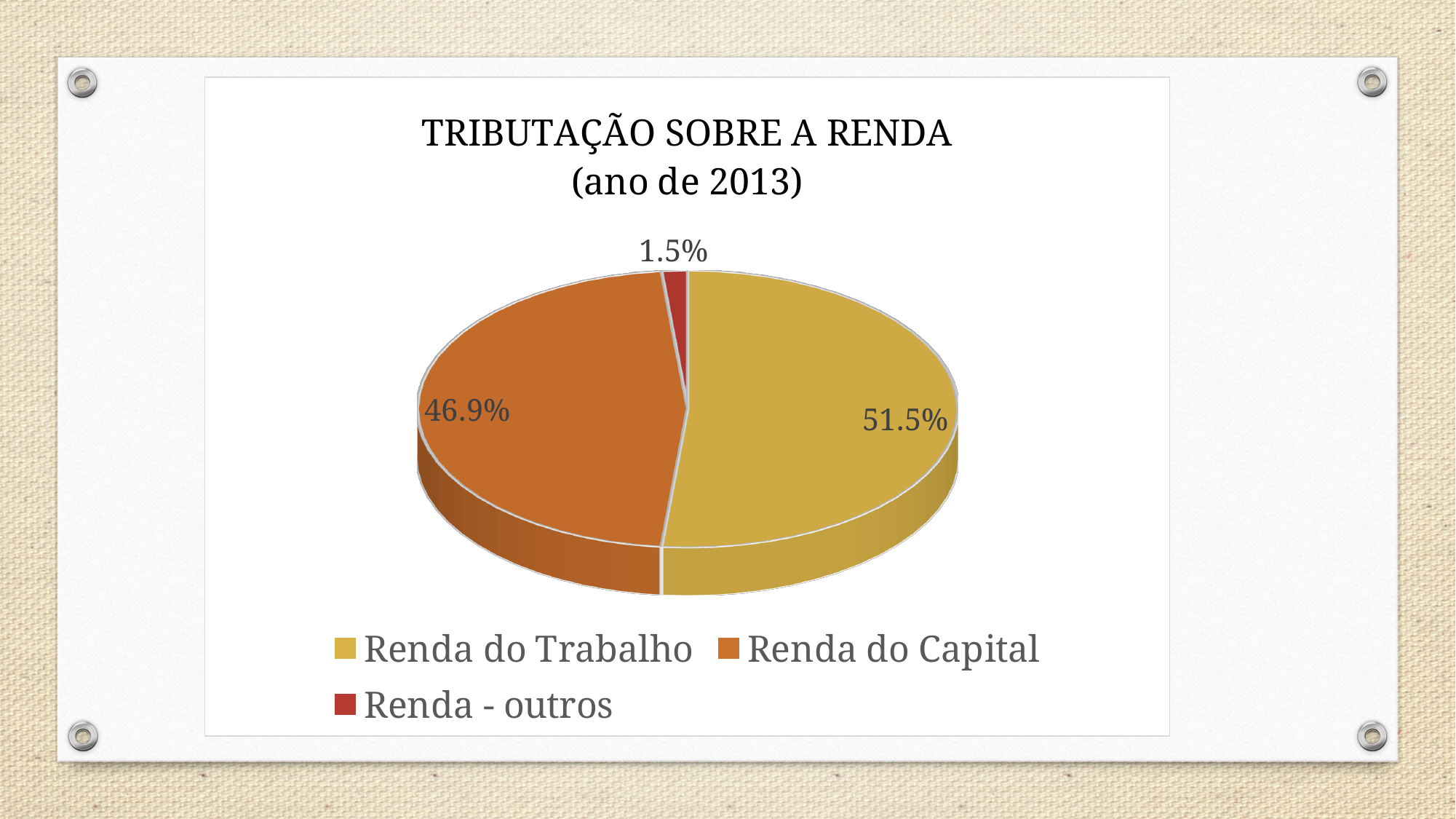
Which category has the largest slice of the pie? Renda do Trabalho What is the difference in percentage points between Renda do Capital and Renda - outros? 45.4 How many slices does the pie chart have? 3 Which is larger, the slice for Renda do Capital or the slice for Renda - outros? Renda do Capital Which colour represents Renda do Capital in the legend? Orange What share of the pie does Renda do Capital represent? 46.9% Which category has the smallest slice of the pie? Renda - outros What kind of chart is shown on the slide? Pie chart What is the difference in percentage points between Renda do Trabalho and Renda do Capital? 4.6 What share of the pie does Renda - outros represent? 1.5% What is the title of the chart? TRIBUTAÇÃO SOBRE A RENDA (ano de 2013) What share of the pie does Renda do Trabalho represent? 51.5%